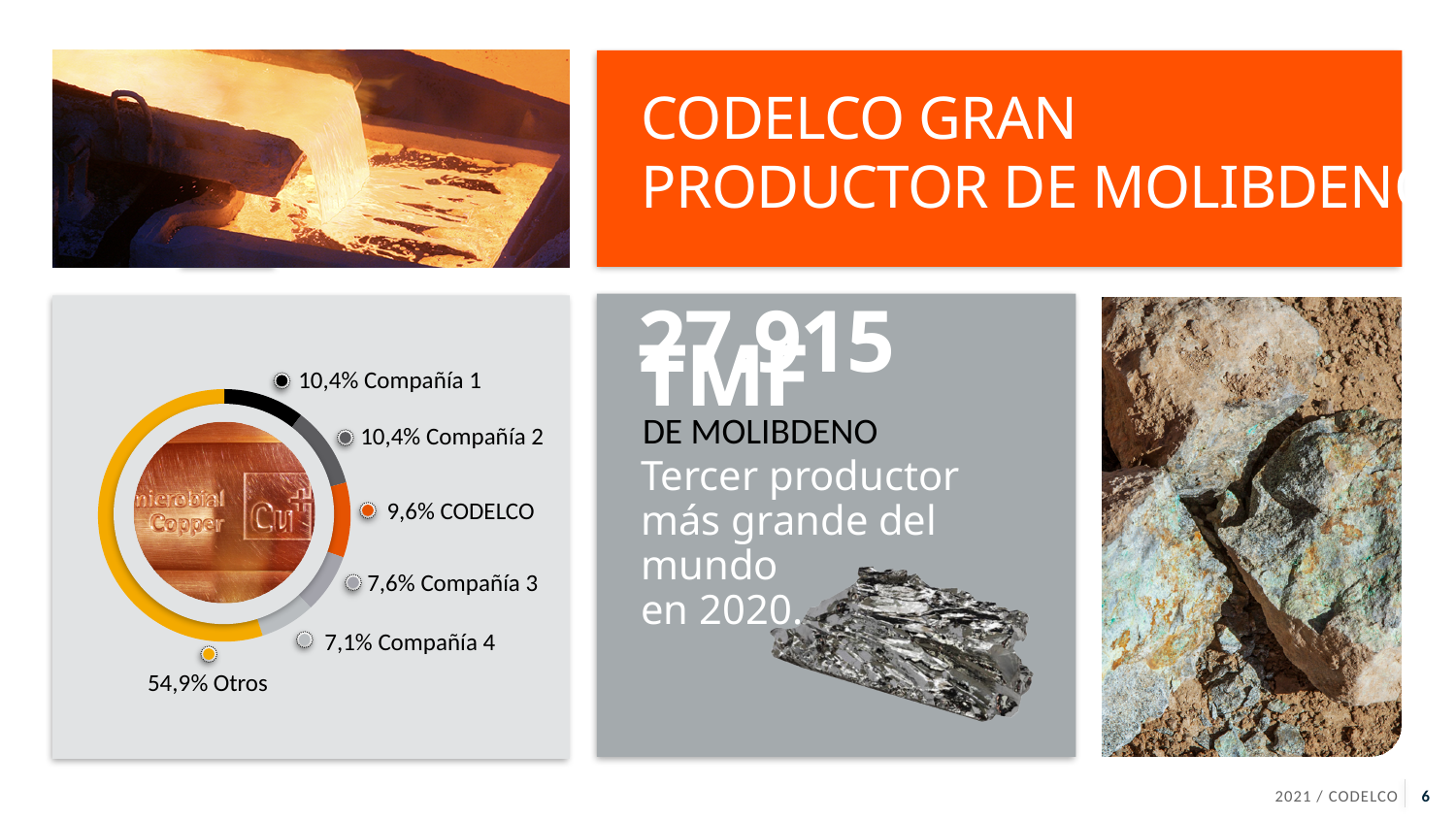
Which is larger, the share for CODELCO or the share for Compañía 3? CODELCO What is the difference between the share for CODELCO and the share for Compañía 4? 2,5% Which category has the largest share in the donut chart? Otros What is the value shown for Otros in the donut chart? 54,9% What is the value shown for Compañía 4? 7,1% What is the value shown for Compañía 3? 7,6% What kind of chart is shown on the left of the slide? Donut (pie) chart What is the difference between the share for Otros and the share for CODELCO? 45,3% What share of the donut chart does CODELCO hold? 9,6% How many categories are shown in the donut chart? 6 Which category has the smallest share in the donut chart? Compañía 4 What colour is the CODELCO segment in the donut chart? Orange